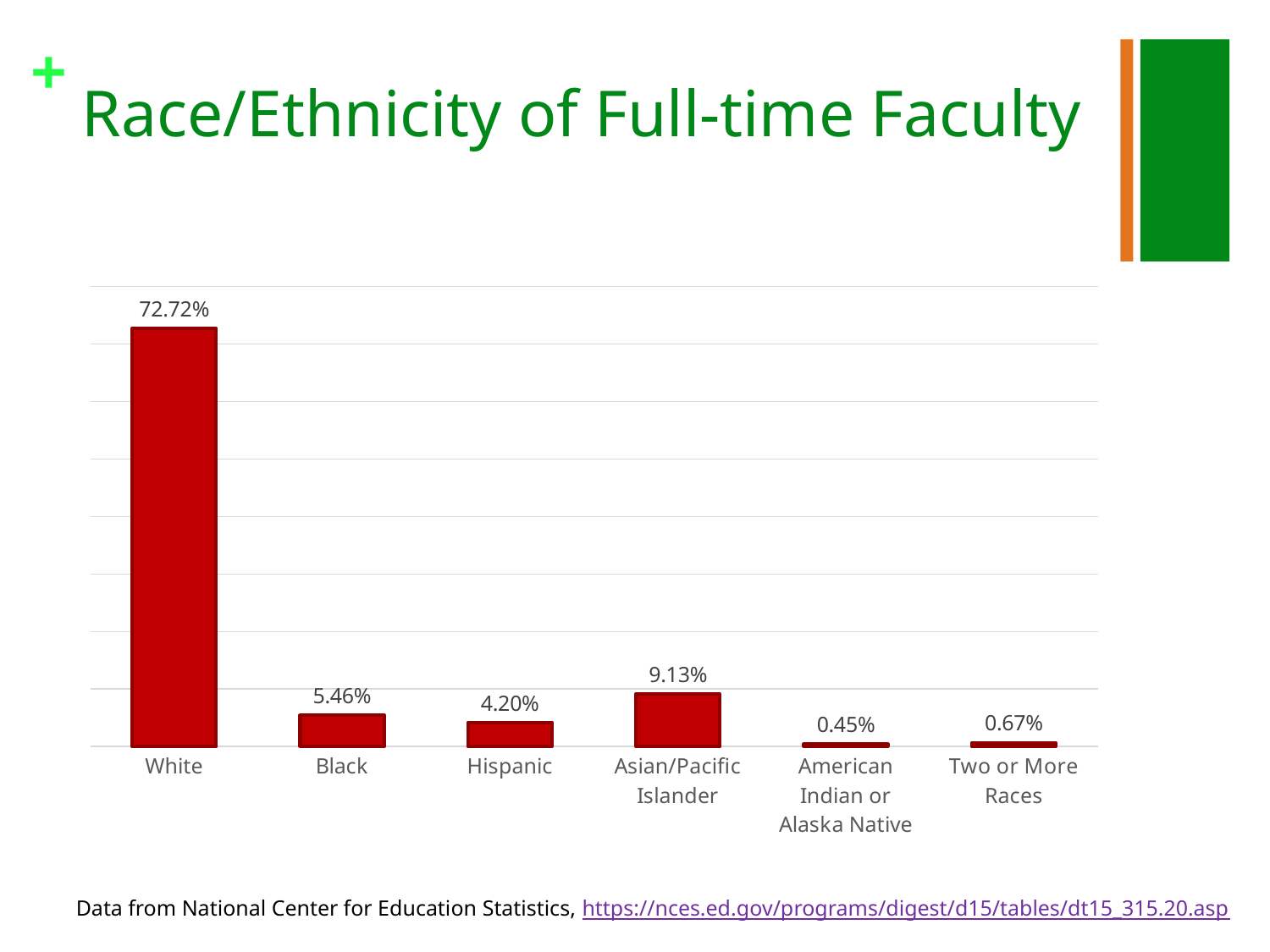
How many race/ethnicity categories are shown in the chart? 6 What is the value shown for Hispanic? 4.20% Which race/ethnicity category has the highest value? White What is the difference between the values for Black and Hispanic? 1.26% What is the value shown for American Indian or Alaska Native? 0.45% Which race/ethnicity category has the lowest value? American Indian or Alaska Native What percentage of full-time faculty is White? 72.72% What is the title of the slide containing the chart? Race/Ethnicity of Full-time Faculty What is the value shown for Asian/Pacific Islander? 9.13% Which is larger, the value for Black or the value for Asian/Pacific Islander? Asian/Pacific Islander What is the difference between the values for White and Asian/Pacific Islander? 63.59% What kind of chart is shown on the slide? Bar chart